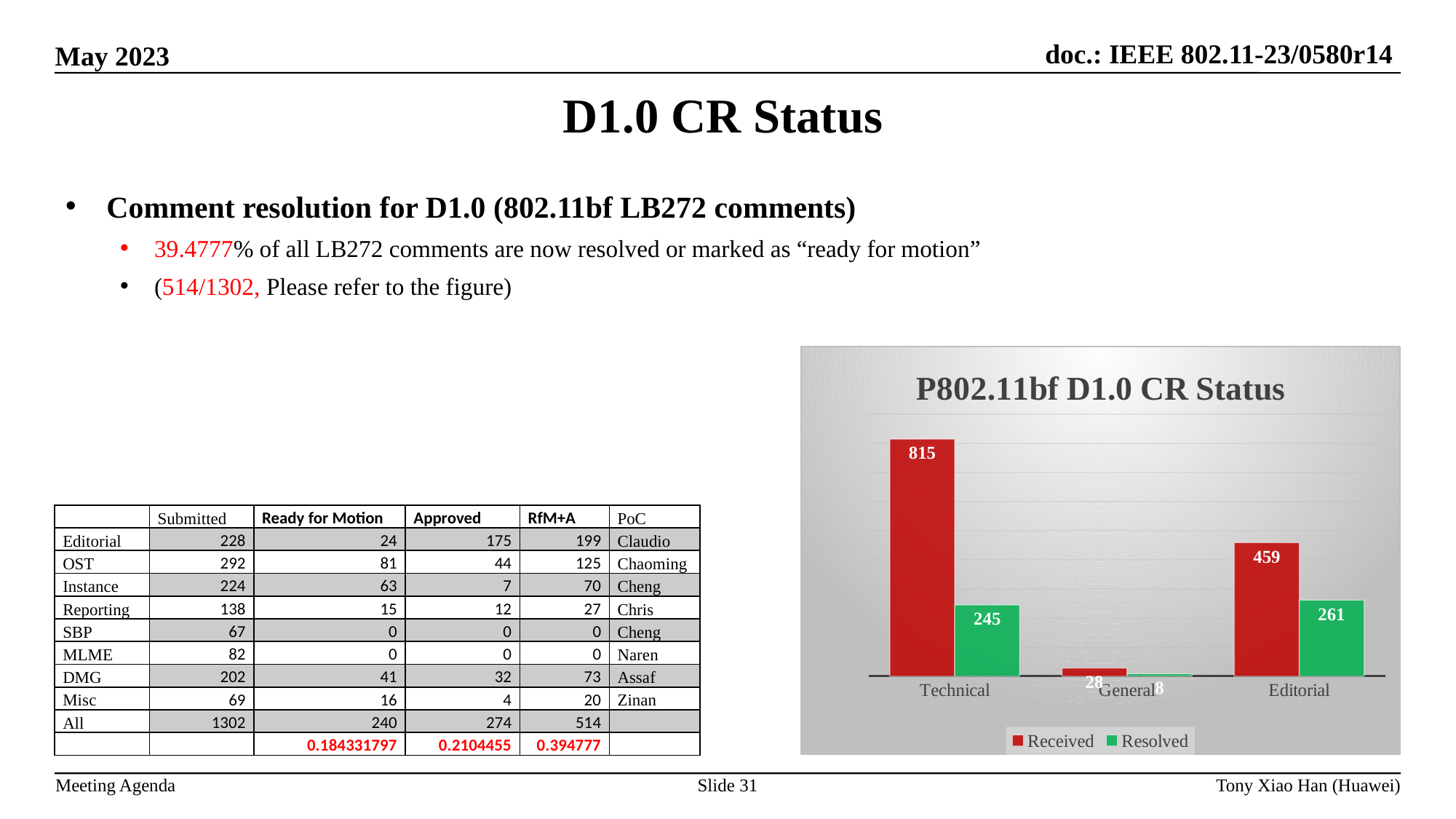
Which series is shown in red in the chart? Received Which category has the lowest Resolved value? General What is the Received value for Technical? 815 What is the Received value for General? 28 What is the difference between Received and Resolved for Technical? 570 How many categories are shown on the x axis of the chart? 3 How many series does the chart legend list? 2 What is the title of the chart? P802.11bf D1.0 CR Status What is the Resolved value for Editorial? 261 Is the Resolved value for Technical or for Editorial larger? Editorial What kind of chart is shown on the slide? bar chart Which category has the highest Received value? Technical